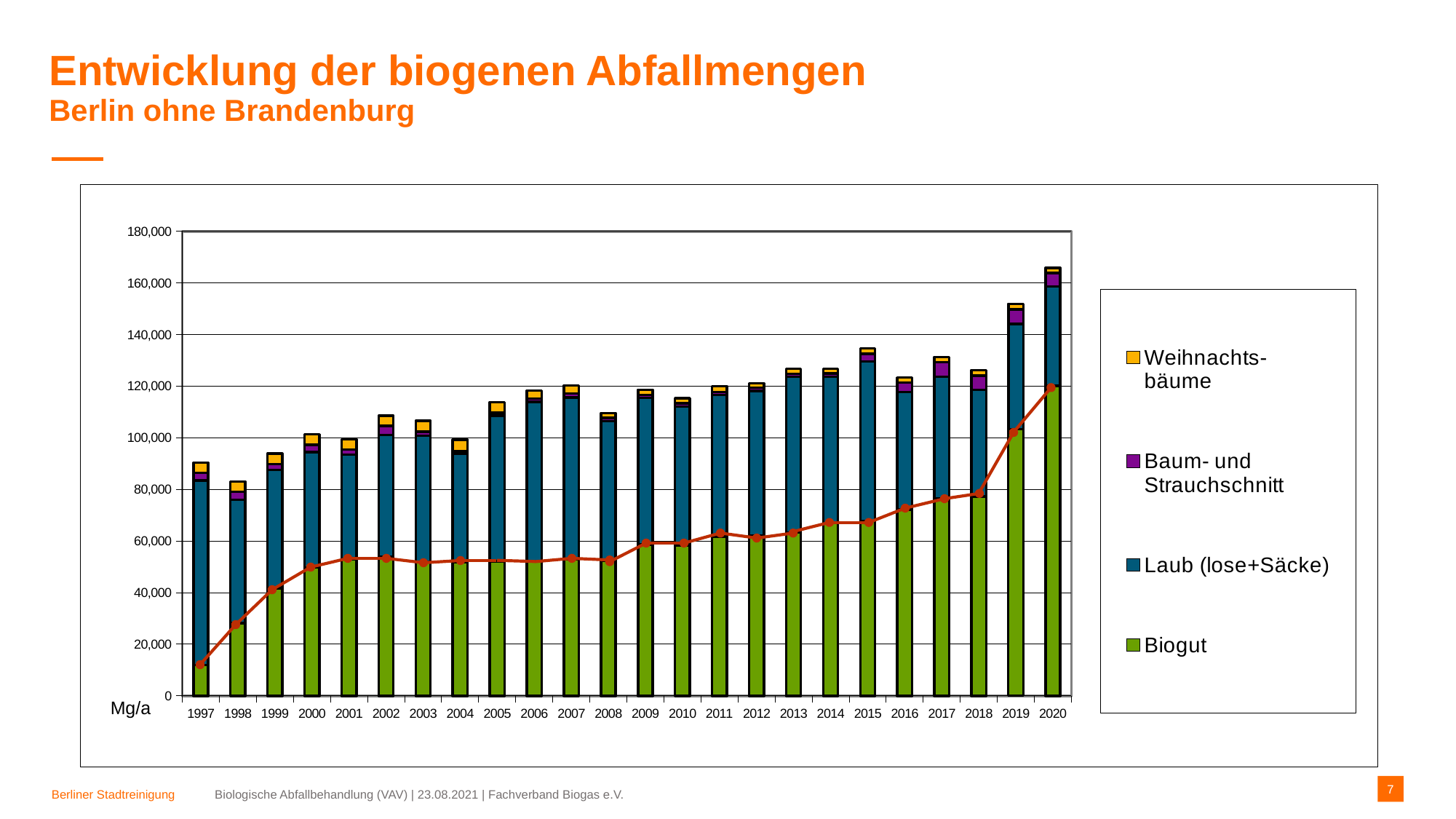
Which year has the highest total stacked bar? 2020 What unit label is shown at the bottom of the y axis? Mg/a What kind of chart is shown on the slide? Stacked bar chart with a line Is the total for 2020 greater or less than 160,000? greater Is the Biogut value for 2020 greater or less than 100,000? greater Does the Biogut series generally rise or fall from 1997 to 2020? rise How many years are shown on the x axis of the chart? 24 Is the Biogut value for 1997 greater or less than 20,000? less Which year has the lowest total stacked bar? 1998 How many series does the legend list? 4 Which year has the larger Biogut value, 2018 or 2019? 2019